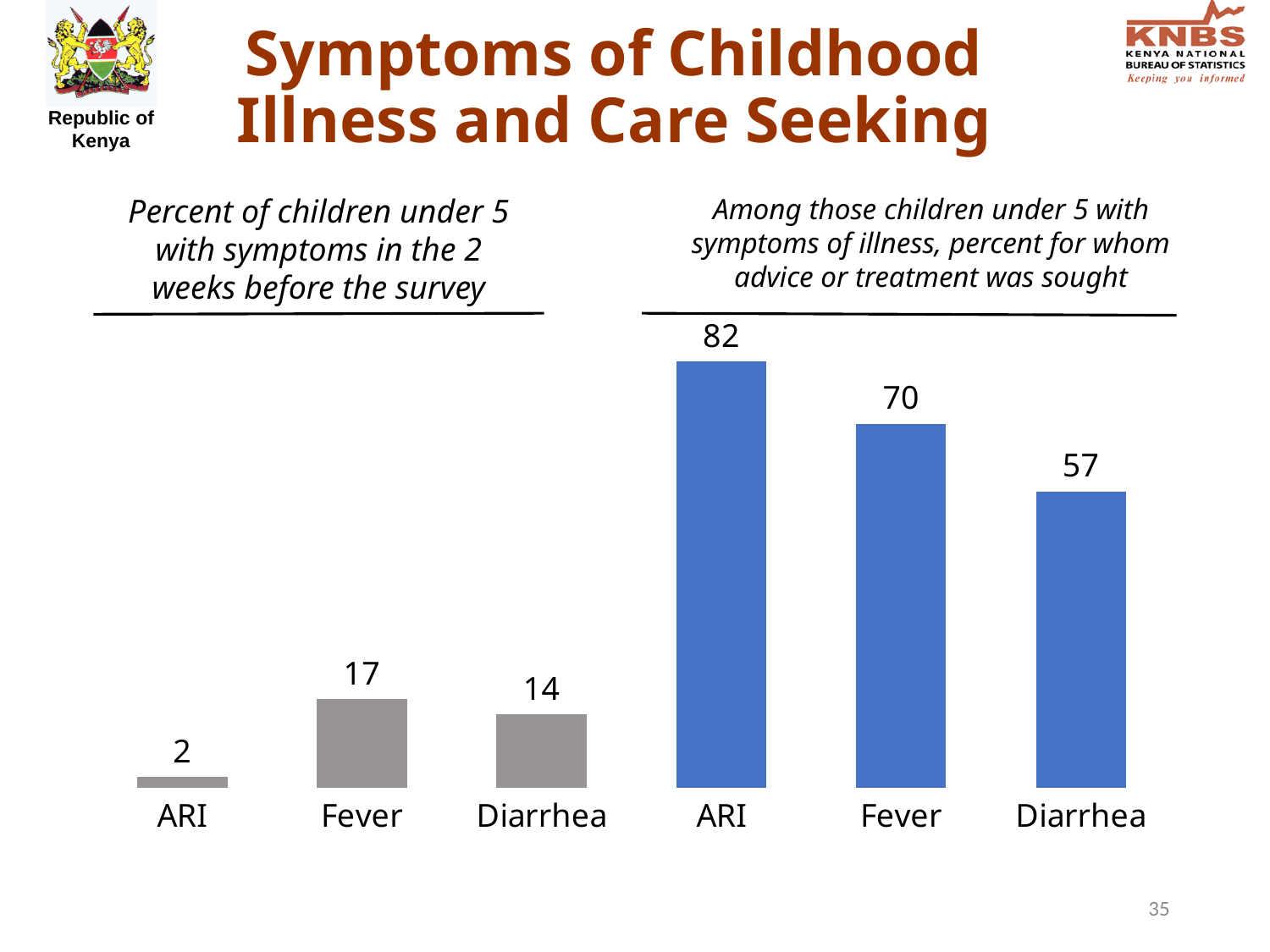
In the right chart (percent for whom advice or treatment was sought), what is the value for Diarrhea? 57 In the right chart (percent for whom advice or treatment was sought), which is larger, the value for Fever or the value for Diarrhea? Fever In the right chart (percent for whom advice or treatment was sought), do the values rise or fall from ARI to Diarrhea? Fall In the left chart (percent of children under 5 with symptoms), what is the value for ARI? 2 In the right chart (percent for whom advice or treatment was sought), which symptom has the highest value? ARI In the left chart (percent of children under 5 with symptoms in the 2 weeks before the survey), what is the value for Fever? 17 In the left chart (percent of children under 5 with symptoms), which symptom has the lowest value? ARI How many categories are shown in the left chart (percent of children under 5 with symptoms)? 3 What kind of chart is the right chart (percent for whom advice or treatment was sought)? Bar chart What colour are the bars in the left chart (percent of children under 5 with symptoms)? Grey In the left chart (percent of children under 5 with symptoms), what is the difference between the values for Fever and Diarrhea? 3 In the right chart (percent for whom advice or treatment was sought), what is the difference between the values for ARI and Fever? 12